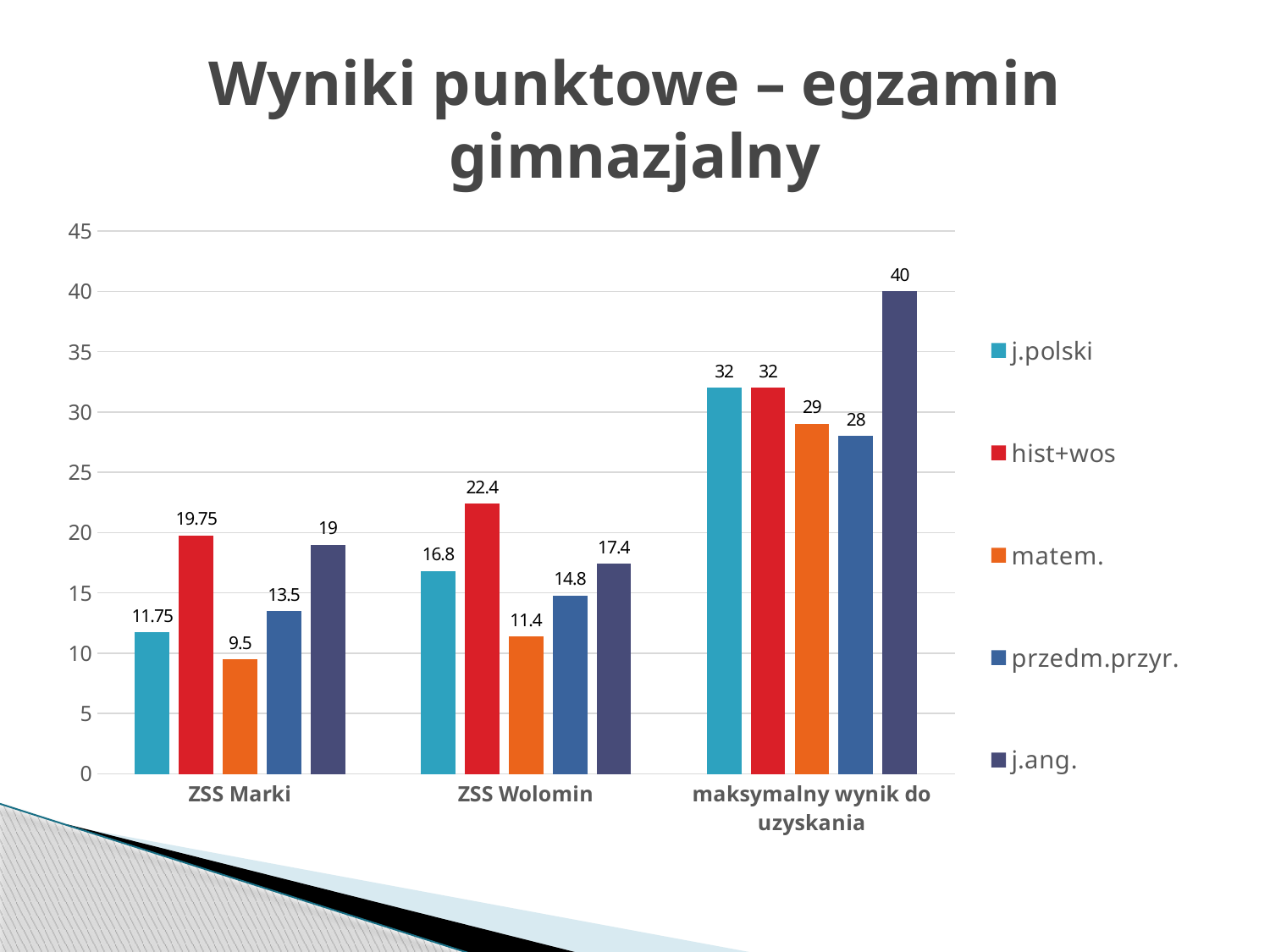
How many series does the legend list? 5 Which series has the lowest value for ZSS Marki? matem. What is the difference between the hist+wos values for ZSS Wolomin and ZSS Marki? 2.65 Which is larger, the przedm.przyr. value for ZSS Marki or for ZSS Wolomin? ZSS Wolomin What is the j.ang. value for maksymalny wynik do uzyskania? 40 How many categories are shown on the x axis? 3 Which series has the highest value for ZSS Wolomin? hist+wos What is the title of the chart on the slide? Wyniki punktowe – egzamin gimnazjalny What is the matem. value for ZSS Wolomin? 11.4 What is the hist+wos value for ZSS Wolomin? 22.4 What is the j.polski value for ZSS Marki? 11.75 What kind of chart is shown on the slide? bar chart